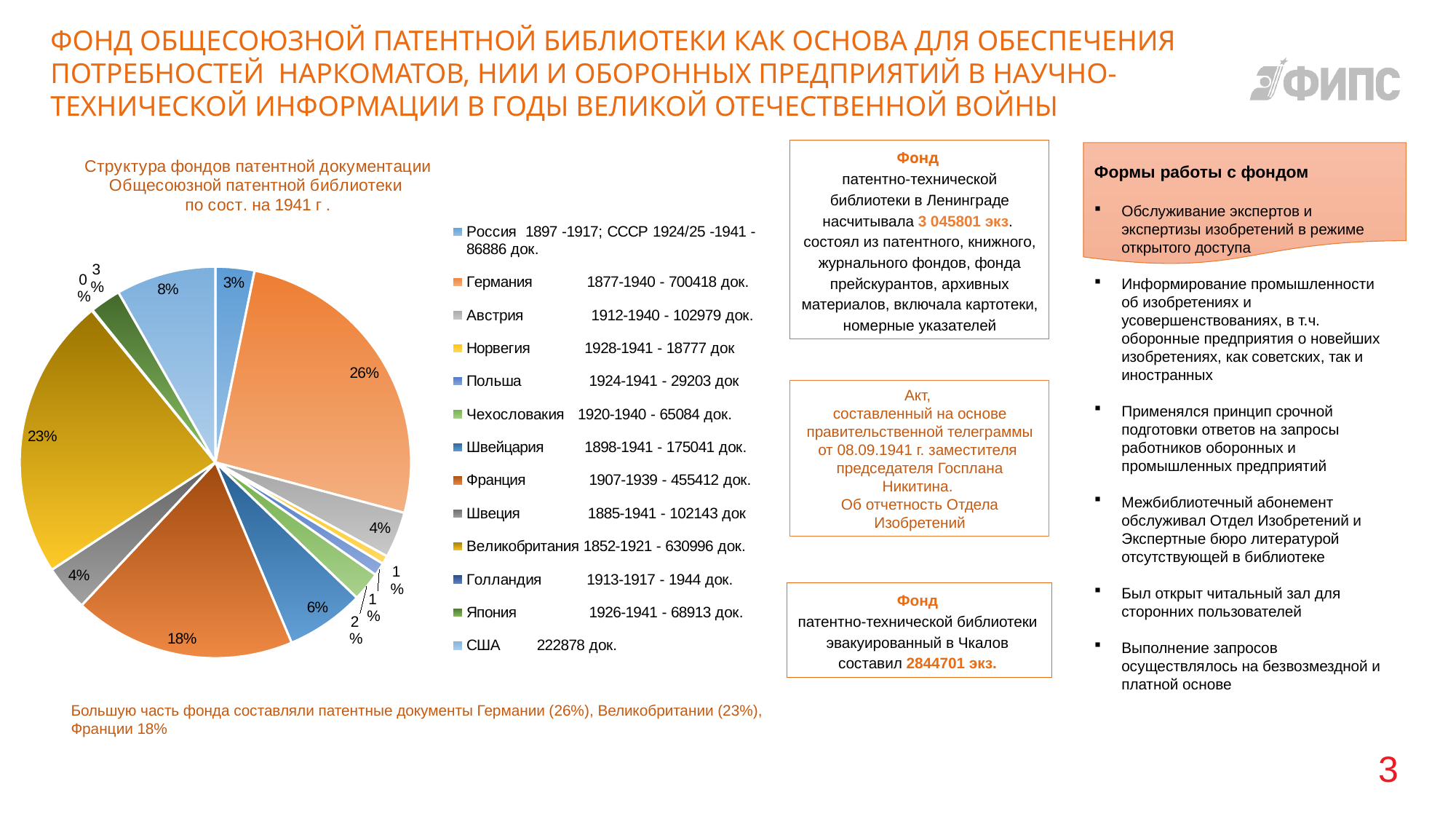
What type of chart is shown on the slide? Pie chart How many categories does the pie chart legend list? 13 Which country has the largest slice in the pie chart? Германия What share of the pie chart does Франция account for? 18% Which has a larger share in the pie chart, Франция or США? Франция By how many percentage points does the share of Германия exceed the share of Великобритания? 3% According to the legend, how many documents does the Германия 1877-1940 entry contain? 700418 док. What share of the pie chart does Швейцария account for? 6% What share of the pie chart does Германия account for? 26% What share of the pie chart does Великобритания account for? 23% Which country has the smallest slice in the pie chart? Голландия What share of the pie chart does США account for? 8%